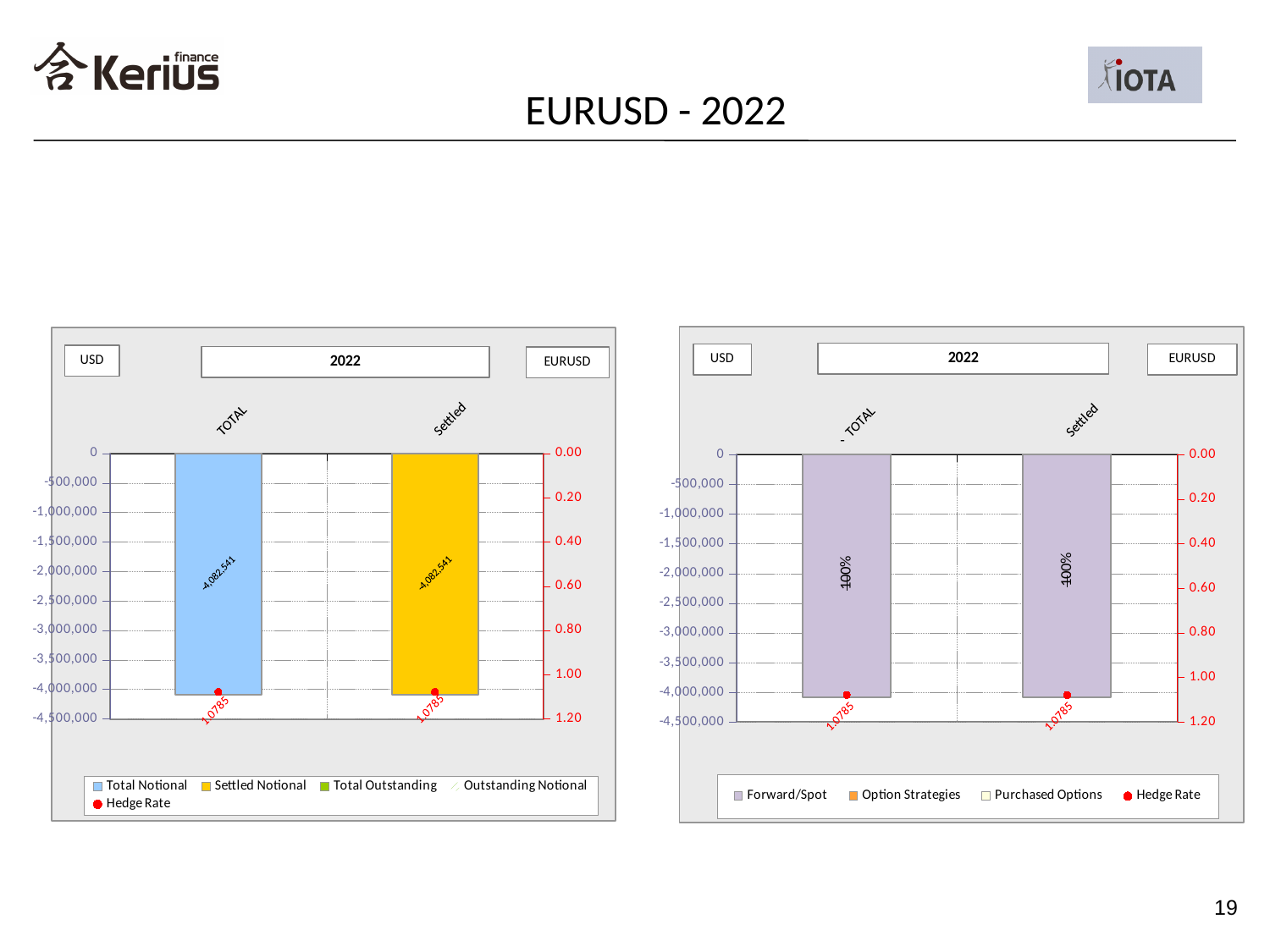
What kind of chart is the left chart? Bar chart with a line/marker series In the right chart, what percentage label is shown on the Settled bar? 100% What is the title shown at the top of the right chart? 2022 How many series does the legend of the right chart list? 4 In the left chart, what is the data label on the Settled bar? -4,082,541 In the right chart, what percentage label is shown on the TOTAL bar? 100% In the left chart, what is the difference between the TOTAL and Settled bar values? 0 How many categories are shown on the x axis of the left chart? 2 How many series does the legend of the left chart list? 5 In the left chart, what Hedge Rate value is labelled at the TOTAL category? 1.0785 In the right chart, what Hedge Rate value is labelled at the Settled category? 1.0785 In the left chart, what is the data label on the TOTAL bar? -4,082,541